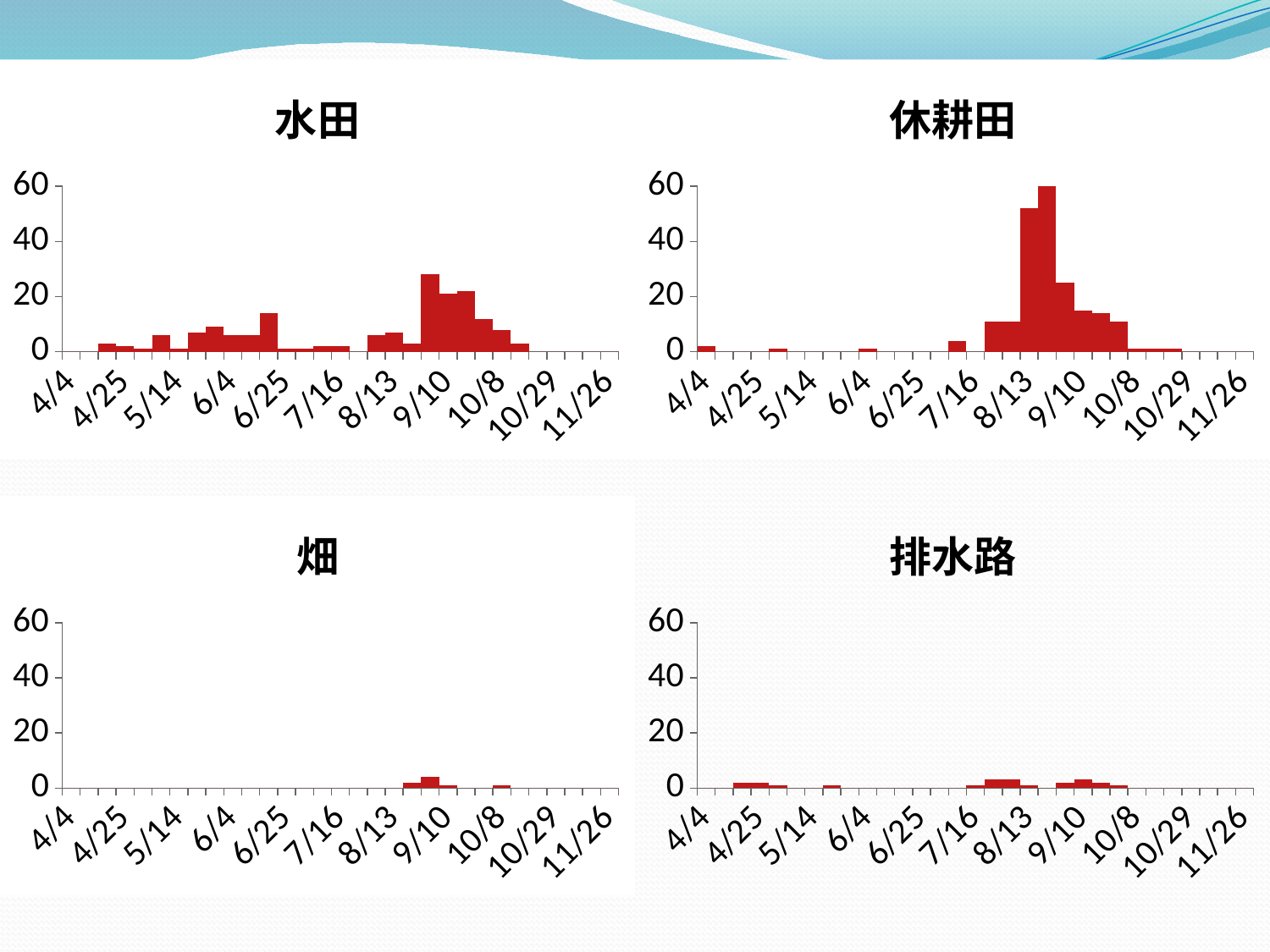
Which of the four charts has the tallest bar? 休耕田 In the 水田 chart, is the tallest bar greater or less than 40? less In the 水田 chart, is the tallest bar greater or less than 20? greater How many charts are shown on the slide? 4 In the 畑 chart, is the tallest bar greater or less than 20? less Which chart has a taller peak, 水田 or 休耕田? 休耕田 What is the title of the chart in the top-right position? 休耕田 What is the title of the chart in the bottom-left position? 畑 What is the highest value shown on the y axis of the 排水路 chart? 60 What kind of chart is the 水田 chart? bar chart